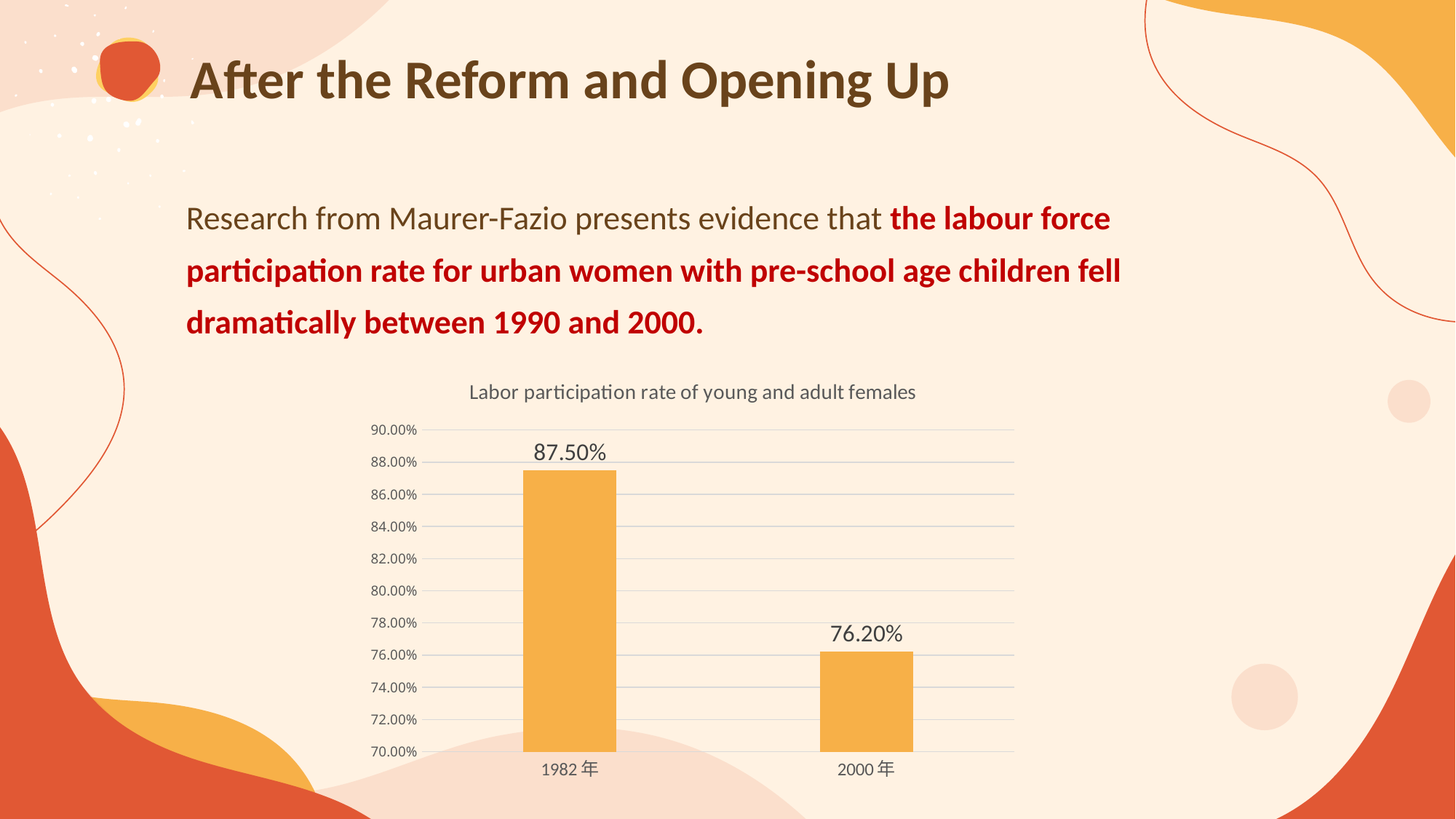
What kind of chart is shown on the slide? bar chart What is the labor participation rate shown for 2000年? 76.20% What is the title of the chart? Labor participation rate of young and adult females Do the values rise or fall from 1982年 to 2000年? fall Which year has the higher labor participation rate? 1982年 Is the value for 1982年 greater or less than 86.00%? greater By how many percentage points does the rate for 1982年 exceed the rate for 2000年? 11.30 percentage points What is the labor participation rate shown for 1982年? 87.50% Which year has the lower labor participation rate? 2000年 Is the value for 1982年 larger or smaller than the value for 2000年? larger How many categories are plotted on the chart? 2 Is the value for 2000年 greater or less than 80.00%? less